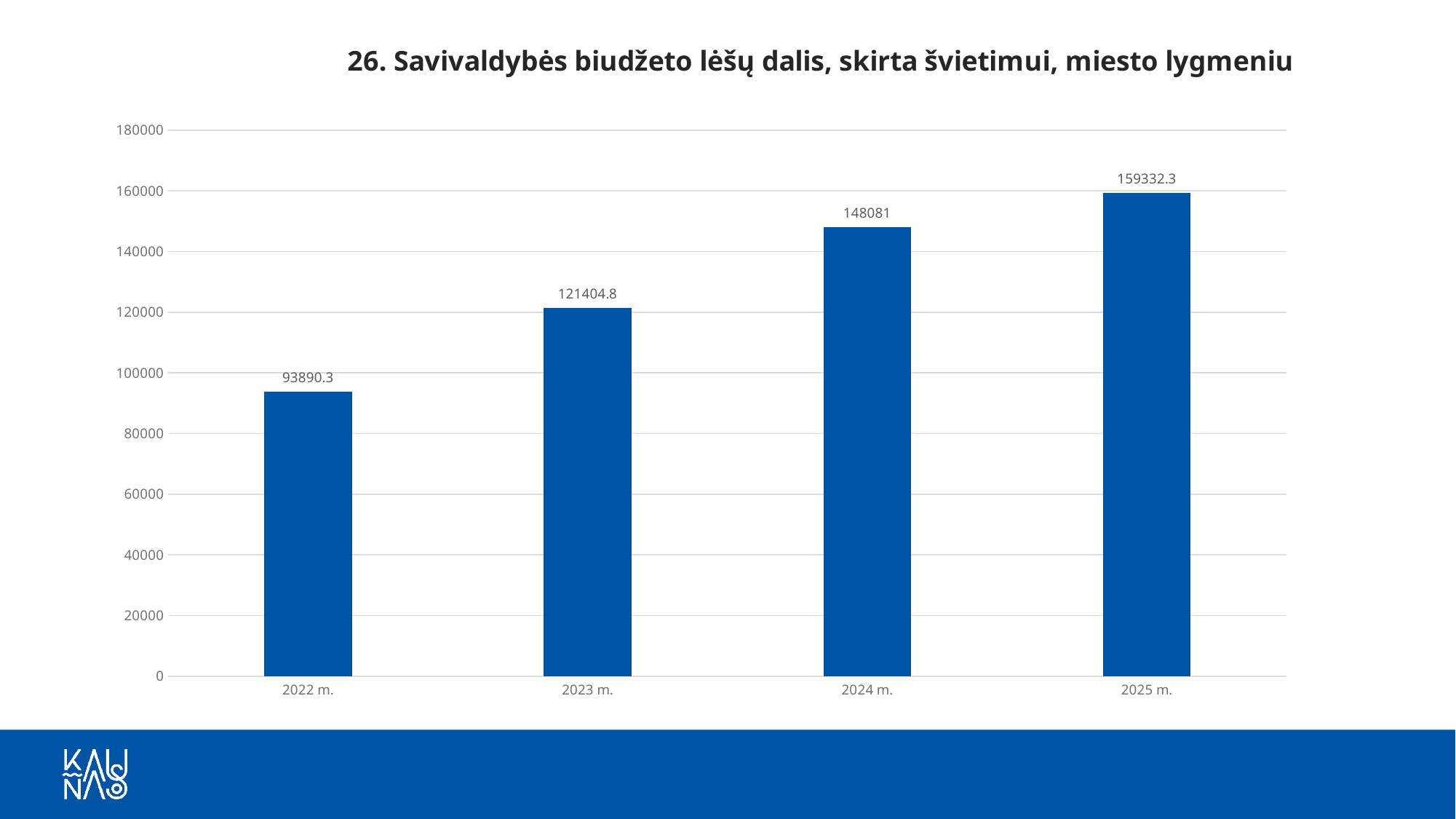
How many years are shown on the x axis? 4 Which is larger, the value for 2023 m. or the value for 2024 m.? 2024 m. Is the value for 2023 m. greater or less than 120000? greater What is the value for 2022 m.? 93890.3 What is the difference between the values for 2025 m. and 2024 m.? 11251.3 What kind of chart is shown on the slide? bar chart Do the values rise or fall from 2022 m. to 2025 m.? rise What is the value for 2024 m.? 148081 Which year has the lowest value? 2022 m. What is the value for 2025 m.? 159332.3 What is the difference between the values for 2023 m. and 2022 m.? 27514.5 Which year has the highest value? 2025 m.